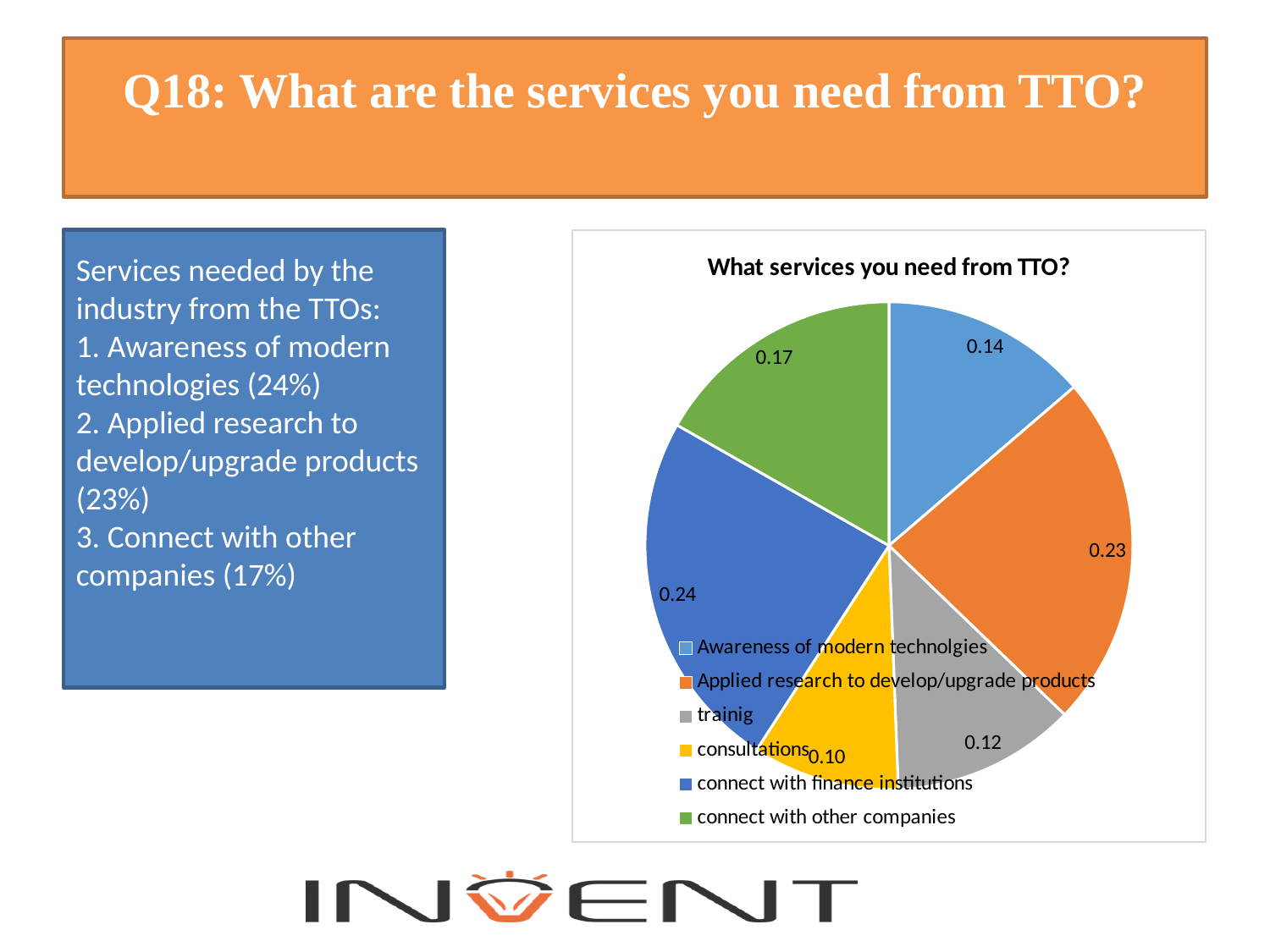
Which is larger, the 'trainig' slice or the 'connect with other companies' slice? connect with other companies How many slices does the pie chart have? 6 Which slice has the smallest value in the pie chart? consultations What type of chart is shown on the slide? pie chart What is the value shown for the 'consultations' slice? 0.10 Which slice has the largest value in the pie chart? connect with finance institutions What is the title of the chart? What services you need from TTO? What is the value shown for the 'trainig' slice? 0.12 What is the value shown for the 'Applied research to develop/upgrade products' slice? 0.23 What is the value shown for the 'connect with other companies' slice? 0.17 What is the difference between the 'connect with finance institutions' value and the 'Awareness of modern technolgies' value? 0.10 Which colour represents 'connect with other companies' in the pie chart? green